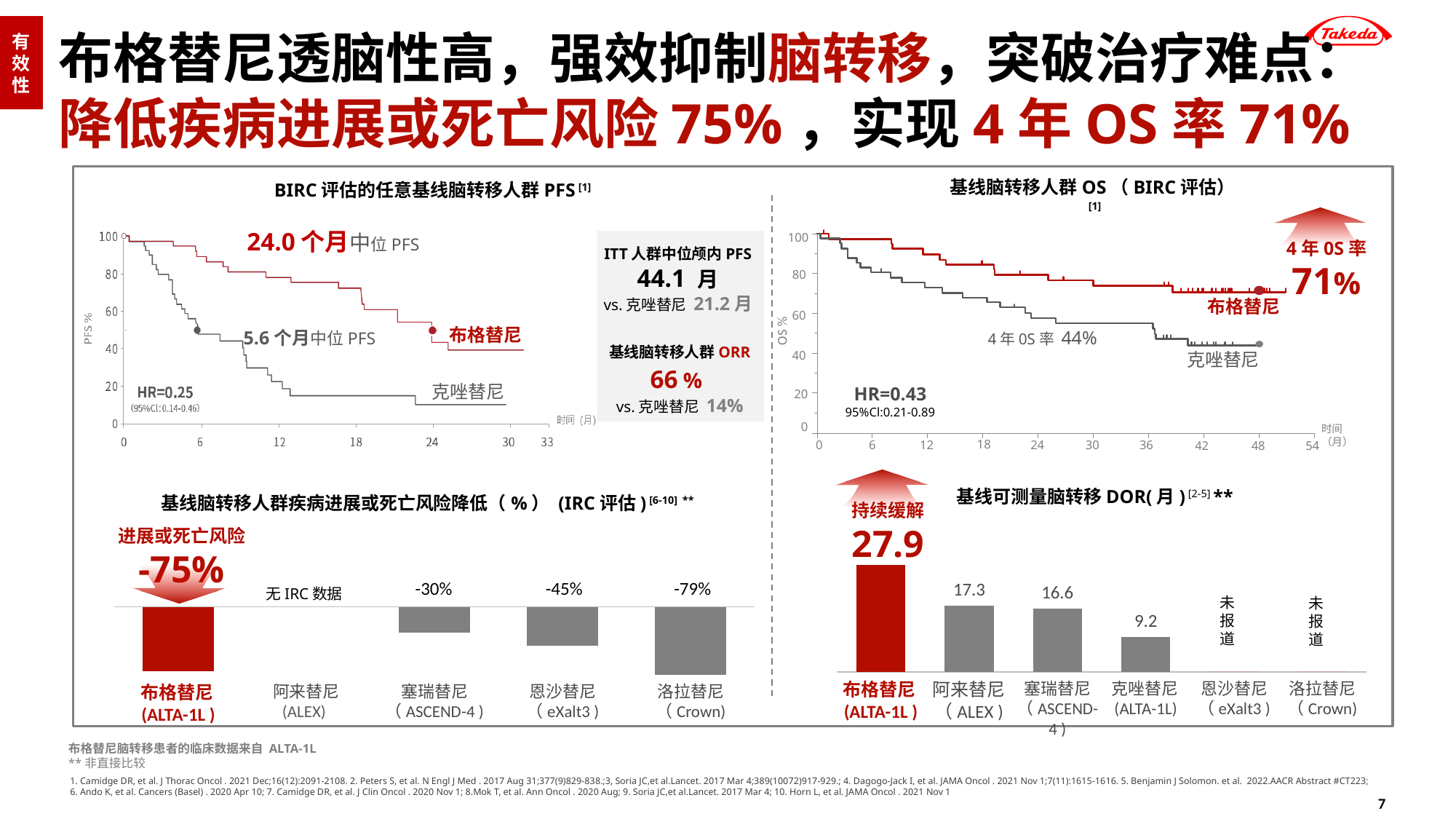
In the bottom-right chart (基线可测量脑转移 DOR), which drug has the highest value? 布格替尼 (ALTA-1L) In the bottom-left chart (基线脑转移人群疾病进展或死亡风险降低), which drug is marked as having no IRC data (无 IRC 数据)? 阿来替尼 (ALEX) In the top-left PFS chart, what is the median PFS for 布格替尼? 24.0 个月 In the bottom-left chart (基线脑转移人群疾病进展或死亡风险降低), what is the value for 洛拉替尼 (Crown)? -79% In the bottom-right chart (基线可测量脑转移 DOR), what is the difference between 布格替尼 and 阿来替尼? 10.6 What kind of chart is the bottom-right chart (基线可测量脑转移 DOR)? bar chart In the bottom-right chart (基线可测量脑转移 DOR), what is the value for 克唑替尼 (ALTA-1L)? 9.2 How many drug categories are shown on the x axis of the bottom-right chart (基线可测量脑转移 DOR)? 6 In the bottom-right chart (基线可测量脑转移 DOR), what is the value for 布格替尼 (ALTA-1L)? 27.9 In the top-right OS chart, what is the 4-year OS rate for 克唑替尼? 44% In the bottom-right chart (基线可测量脑转移 DOR), which is larger, 阿来替尼 or 塞瑞替尼? 阿来替尼 In the bottom-left chart (基线脑转移人群疾病进展或死亡风险降低), what is the value for 塞瑞替尼 (ASCEND-4)? -30%